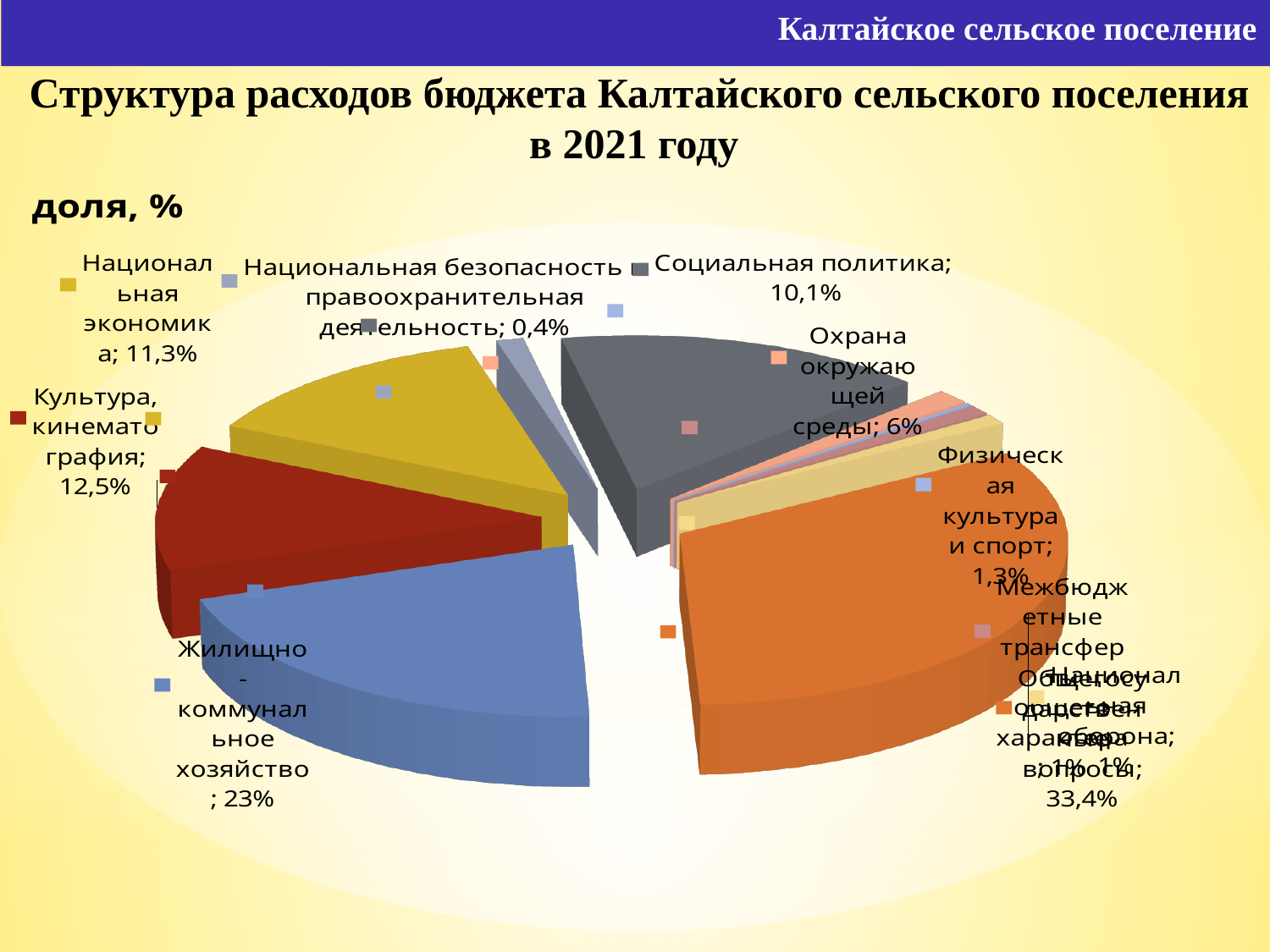
What share is shown for Жилищно-коммунальное хозяйство? 23% What type of chart is shown on the slide? Pie chart What share is shown for Охрана окружающей среды? 6% What share is shown for Физическая культура и спорт? 1,3% What share of the budget expenditure goes to Общегосударственные вопросы? 33,4% What share is shown for Социальная политика? 10,1% Which expenditure category has the largest share of the budget? Общегосударственные вопросы What share is shown for Национальная экономика? 11,3% Which expenditure category has the smallest share, at 0,4%? Национальная безопасность и правоохранительная деятельность What share is shown for Культура, кинематография? 12,5% Which has a larger share: Культура, кинематография or Национальная экономика? Культура, кинематография By how many percentage points does the share of Общегосударственные вопросы exceed that of Жилищно-коммунальное хозяйство? 10,4